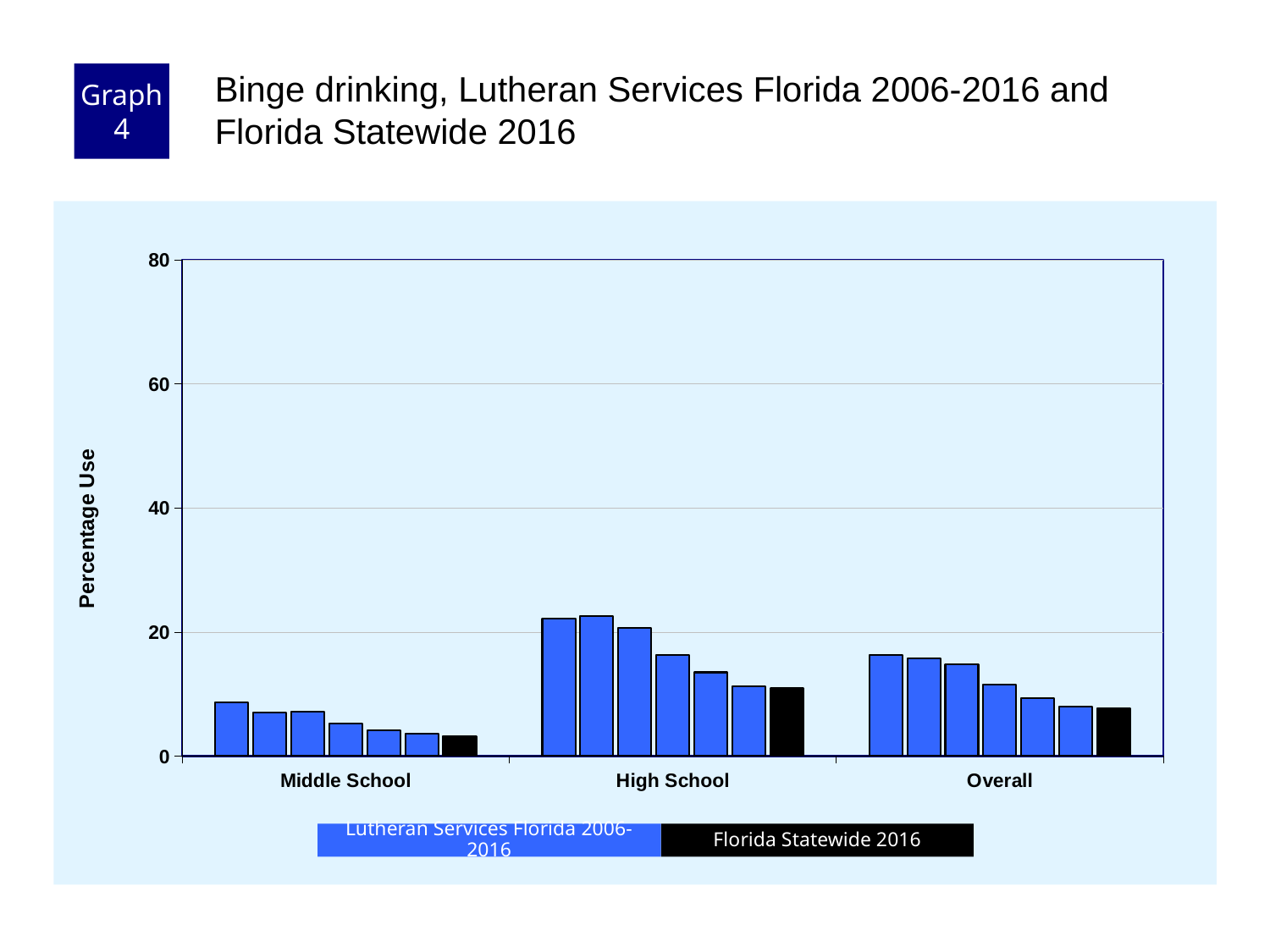
Within the High School group, do the Lutheran Services Florida bars rise or fall from left to right? fall How many categories are shown on the x axis? 3 What colour are the Florida Statewide 2016 bars? black Which category has the lowest bars? Middle School How many series does the legend list? 2 Is the Florida Statewide 2016 value for Overall greater or less than 20? less Which category has the highest bars? High School What is the label on the y axis? Percentage Use Is the highest High School bar greater or less than 40? less What kind of chart is shown on the slide? bar chart Are the bars for High School higher or lower than the bars for Middle School? higher Is the Florida Statewide 2016 value for Middle School greater or less than 20? less